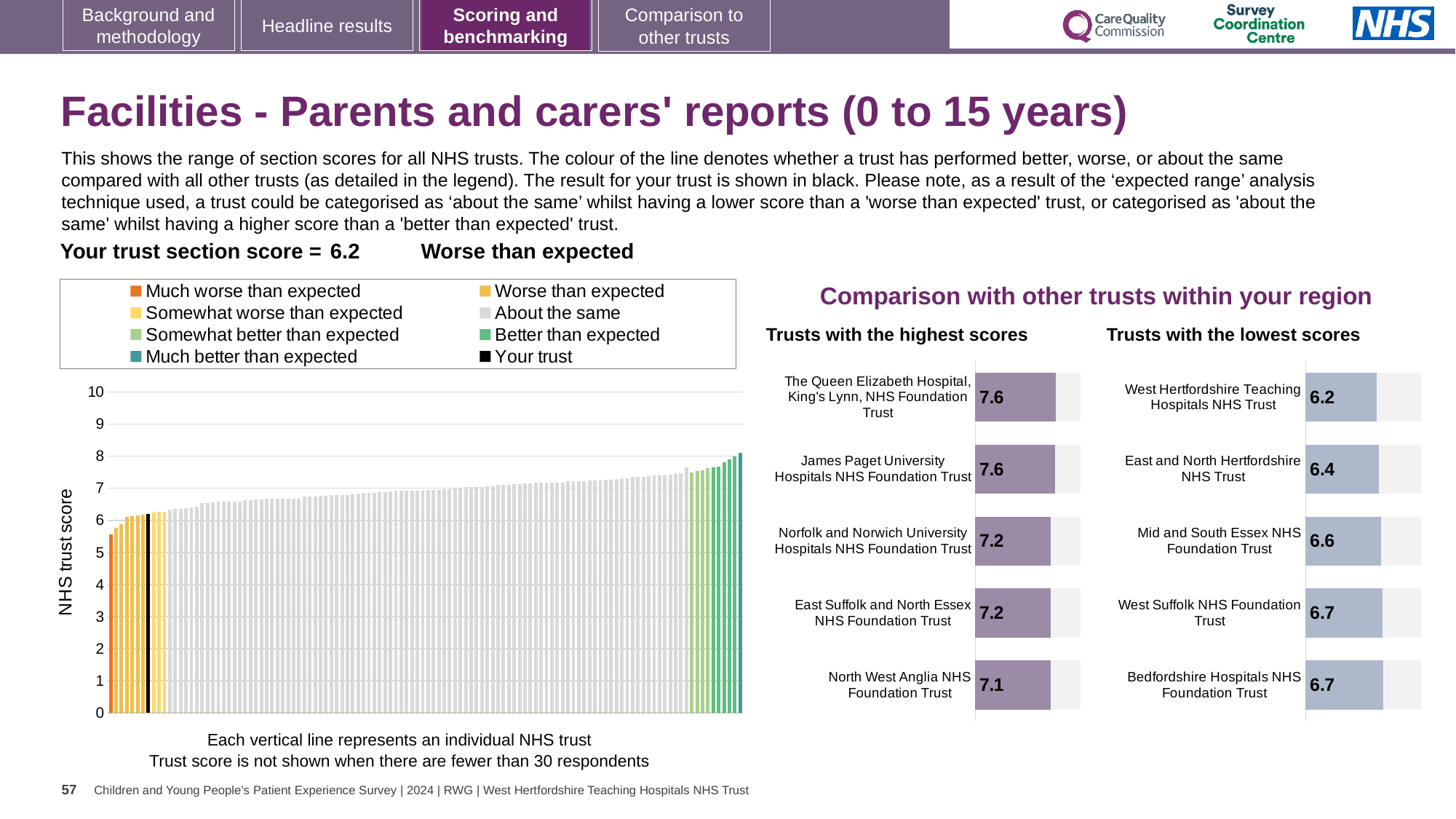
How many entries does the legend of the main NHS trust score chart on the left list? 8 In the 'Trusts with the highest scores' chart, what is the score for Norfolk and Norwich University Hospitals NHS Foundation Trust? 7.2 In the 'Trusts with the lowest scores' chart, which trust has the lowest score? West Hertfordshire Teaching Hospitals NHS Trust In the main NHS trust score chart on the left, do the bar values rise or fall from left to right? Rise What is the y-axis title of the main NHS trust score chart on the left? NHS trust score In the 'Trusts with the highest scores' chart, what is the difference between the scores of The Queen Elizabeth Hospital, King's Lynn, NHS Foundation Trust and North West Anglia NHS Foundation Trust? 0.5 How many trusts are shown in the 'Trusts with the highest scores' chart? 5 In the 'Trusts with the lowest scores' chart, what is the score for East and North Hertfordshire NHS Trust? 6.4 In the 'Trusts with the lowest scores' chart, what is the difference between the scores of Mid and South Essex NHS Foundation Trust and West Hertfordshire Teaching Hospitals NHS Trust? 0.4 What kind of chart is the main NHS trust score chart on the left of the slide? Bar chart In the 'Trusts with the highest scores' chart, which trust has the lowest score? North West Anglia NHS Foundation Trust In the 'Trusts with the lowest scores' chart, which has the higher score: East and North Hertfordshire NHS Trust or West Suffolk NHS Foundation Trust? West Suffolk NHS Foundation Trust